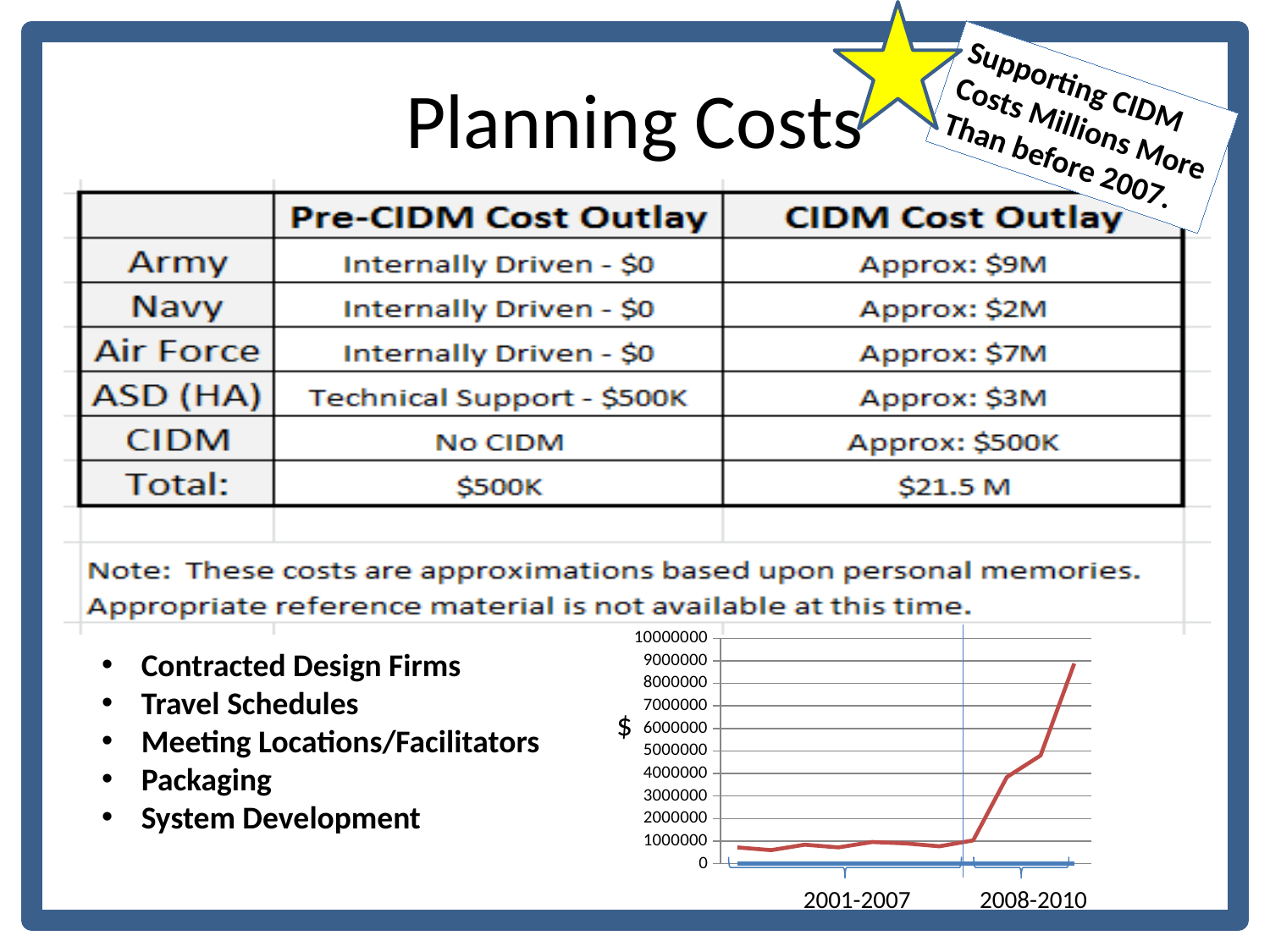
In the line chart, are the values during 2001-2007 greater or less than 2000000? less What kind of chart is shown at the bottom right of the slide? line chart In the line chart, is the highest plotted value greater or less than 5000000? greater In the line chart, which period shows higher values, 2001-2007 or 2008-2010? 2008-2010 In the line chart, is the first value (start of 2001-2007) greater or less than 1000000? less What label is shown on the y axis of the line chart? $ In the line chart, do the values rise or fall moving from the 2001-2007 period to the 2008-2010 period? rise What is the highest tick value shown on the y axis of the line chart? 10000000